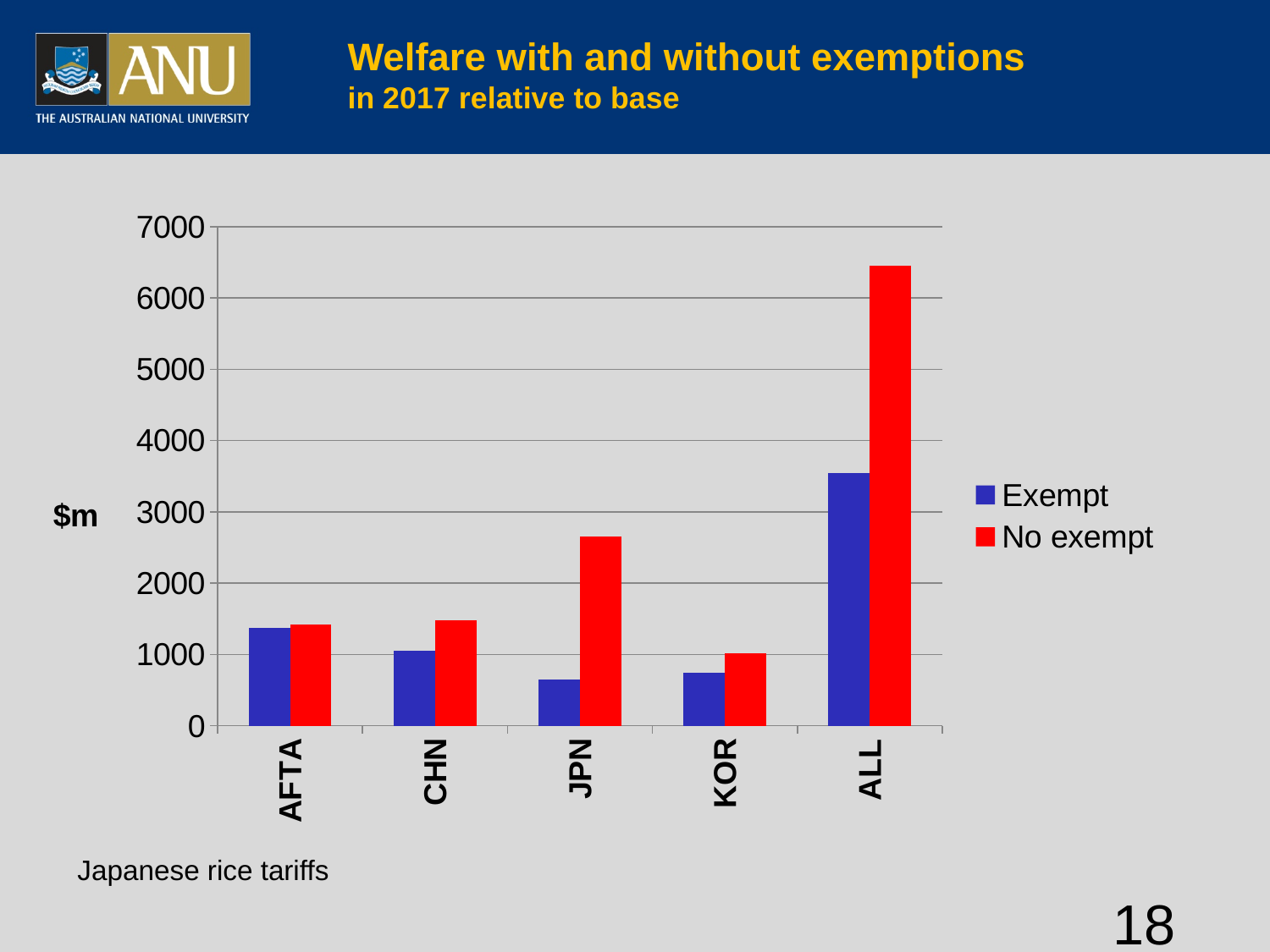
What is the label on the vertical axis of the chart? $m Is the No exempt value for JPN greater or less than 2000? greater What are the two entries listed in the chart's legend? Exempt and No exempt Is the No exempt value for ALL greater or less than 6000? greater For JPN, which is larger: the Exempt value or the No exempt value? No exempt Is the Exempt value for ALL greater or less than 3000? greater How many series does the chart's legend list? 2 Which category has the highest No exempt value? ALL How many categories are shown on the x axis of the chart? 5 Which category has the lowest No exempt value? KOR What kind of chart is shown on the slide? bar chart